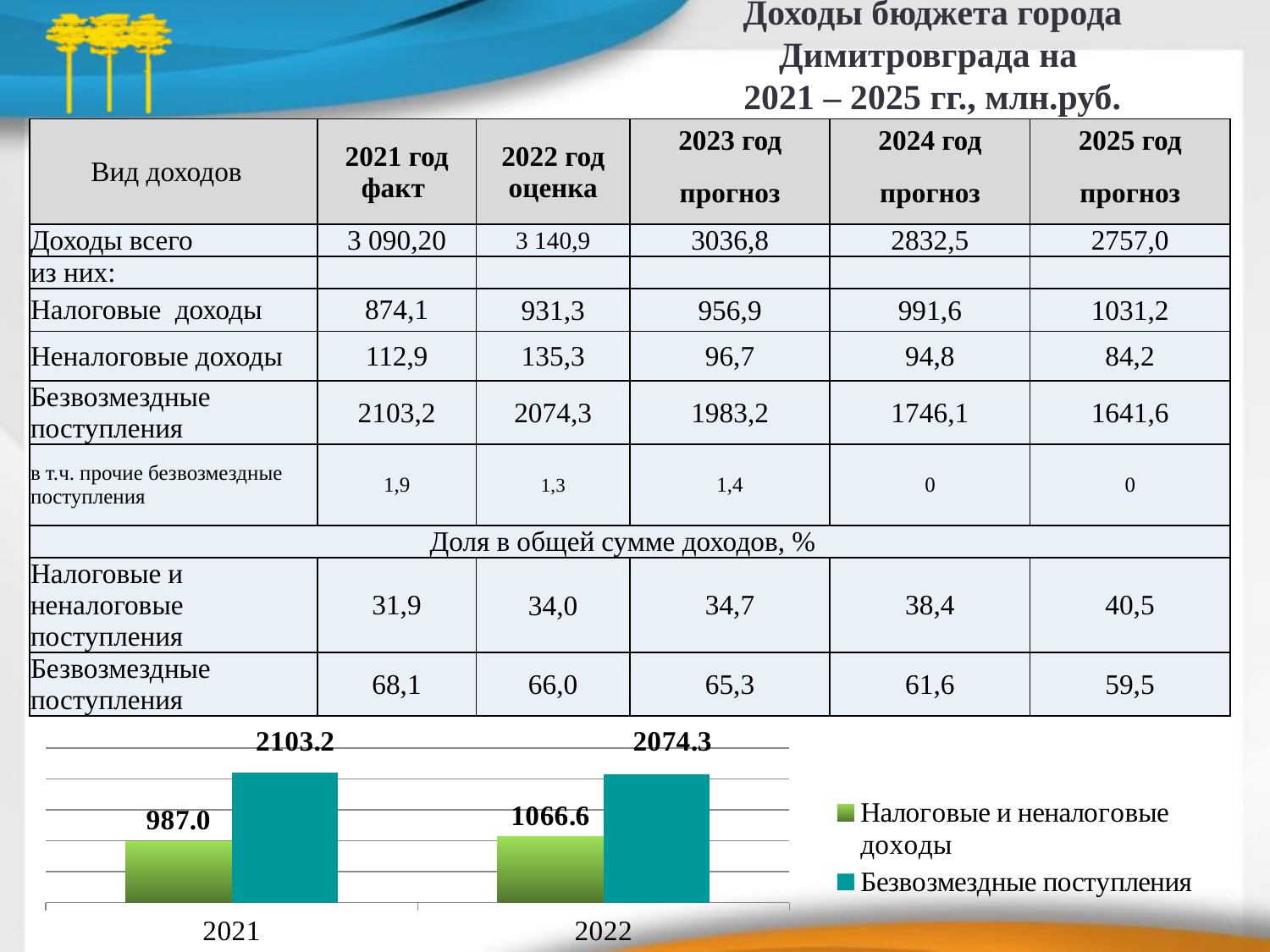
How many series does the legend of the bar chart list? 2 In the bar chart, what is the difference between Безвозмездные поступления and Налоговые и неналоговые доходы in 2021? 1116.2 In the bar chart, what is the value of Налоговые и неналоговые доходы for 2021? 987.0 How many categories are shown on the x axis of the bar chart? 2 In the bar chart, do the values for Безвозмездные поступления rise or fall from 2021 to 2022? fall In the bar chart, what is the value of Безвозмездные поступления for 2021? 2103.2 In the bar chart, what is the value of Налоговые и неналоговые доходы for 2022? 1066.6 In the bar chart, what is the value of Безвозмездные поступления for 2022? 2074.3 In the bar chart, which year has the lower value for Безвозмездные поступления? 2022 What kind of chart is shown at the bottom of the slide? bar chart In the bar chart, which year has the higher value for Налоговые и неналоговые доходы? 2022 In the bar chart, which series is shown in green? Налоговые и неналоговые доходы